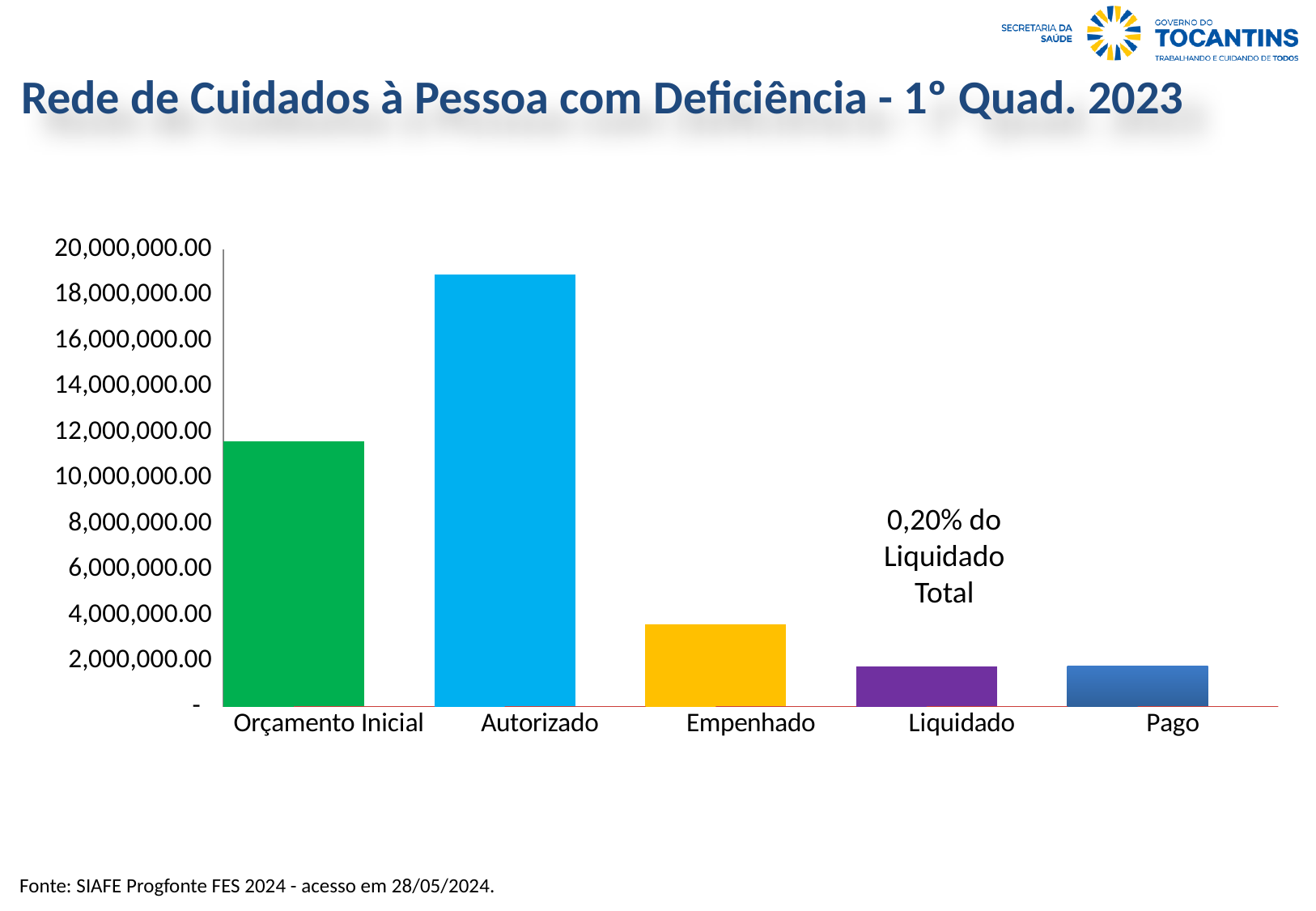
Is the value for Empenhado greater or less than 4,000,000.00? less Is the value for Liquidado greater or less than 2,000,000.00? less Which is larger, the value for Autorizado or the value for Orçamento Inicial? Autorizado How many categories are shown on the x axis of the chart? 5 What kind of chart is shown on the slide? bar chart Which is larger, the value for Empenhado or the value for Pago? Empenhado Is the value for Orçamento Inicial greater or less than 12,000,000.00? less What text annotation appears above the Liquidado bar? 0,20% do Liquidado Total Which category has the highest value in the chart? Autorizado What is the title of the slide containing the chart? Rede de Cuidados à Pessoa com Deficiência - 1° Quad. 2023